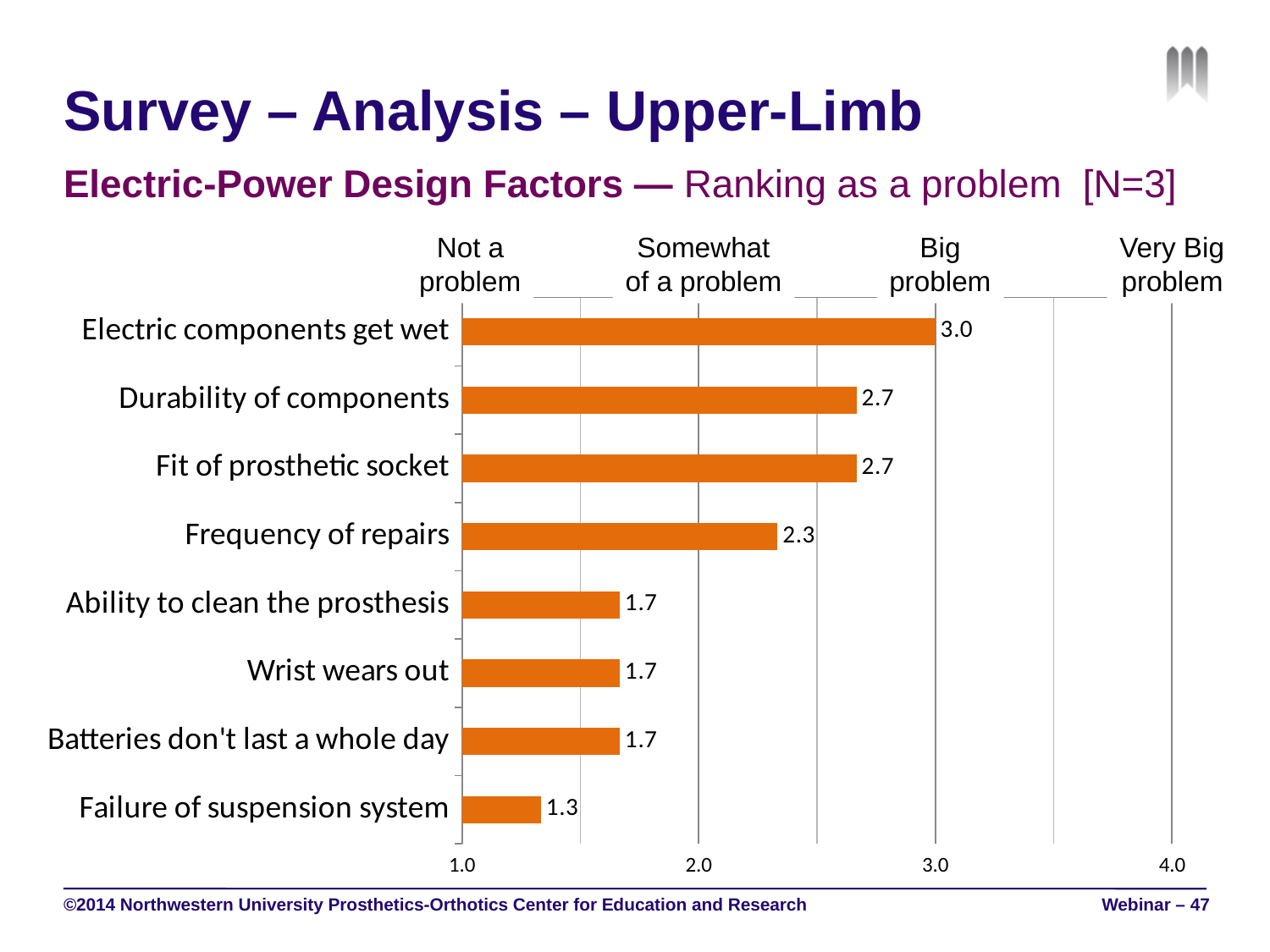
What is the value for Electric components get wet? 3.0 What is the value for Durability of components? 2.7 Which category has the lowest value? Failure of suspension system Which is larger, the value for Frequency of repairs or the value for Wrist wears out? Frequency of repairs Is the value for Fit of prosthetic socket greater or less than 2.0? greater What label appears at the 4.0 end of the axis scale? Very Big problem Which category has the highest value? Electric components get wet How many categories are shown in the chart? 8 What kind of chart is shown on the slide? Bar chart What is the difference between the values for Electric components get wet and Failure of suspension system? 1.7 What is the value for Failure of suspension system? 1.3 What is the value for Frequency of repairs? 2.3